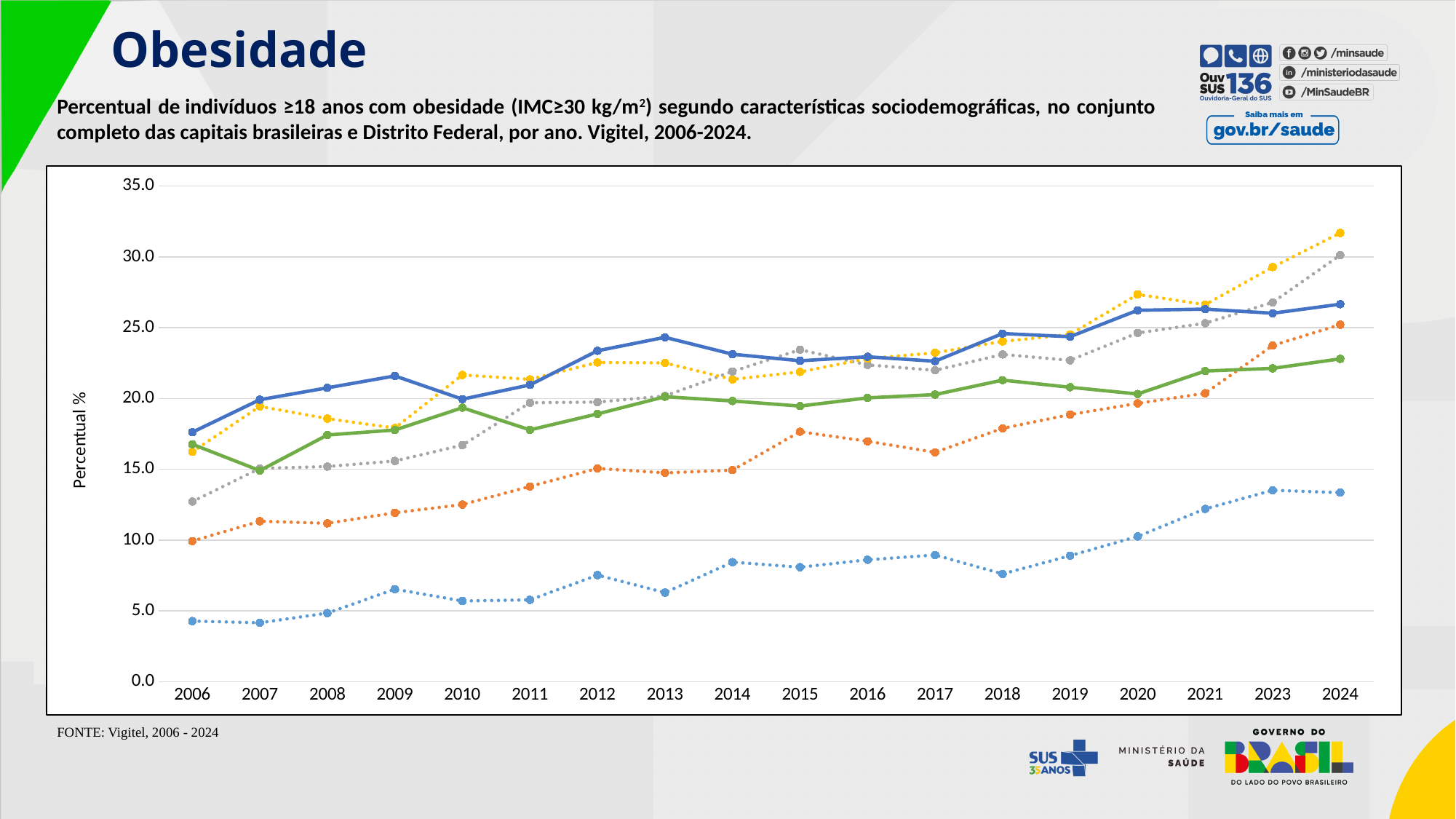
In which year does the yellow dotted line reach its highest value? 2024 Is the value of the light blue dotted line in 2006 greater or less than 5.0? less In which year does the grey dotted line have its lowest value? 2006 Does the light blue dotted line generally rise or fall from 2006 to 2024? rise Is the value of the dark blue solid line in 2020 greater or less than 25.0? greater What type of chart is shown on the slide? line chart Is the value of the yellow dotted line in 2024 greater or less than 30.0? greater How many years are shown on the x axis of the chart? 18 What is the label of the y axis of the chart? Percentual % In 2024, which is higher: the yellow dotted line or the grey dotted line? yellow dotted line